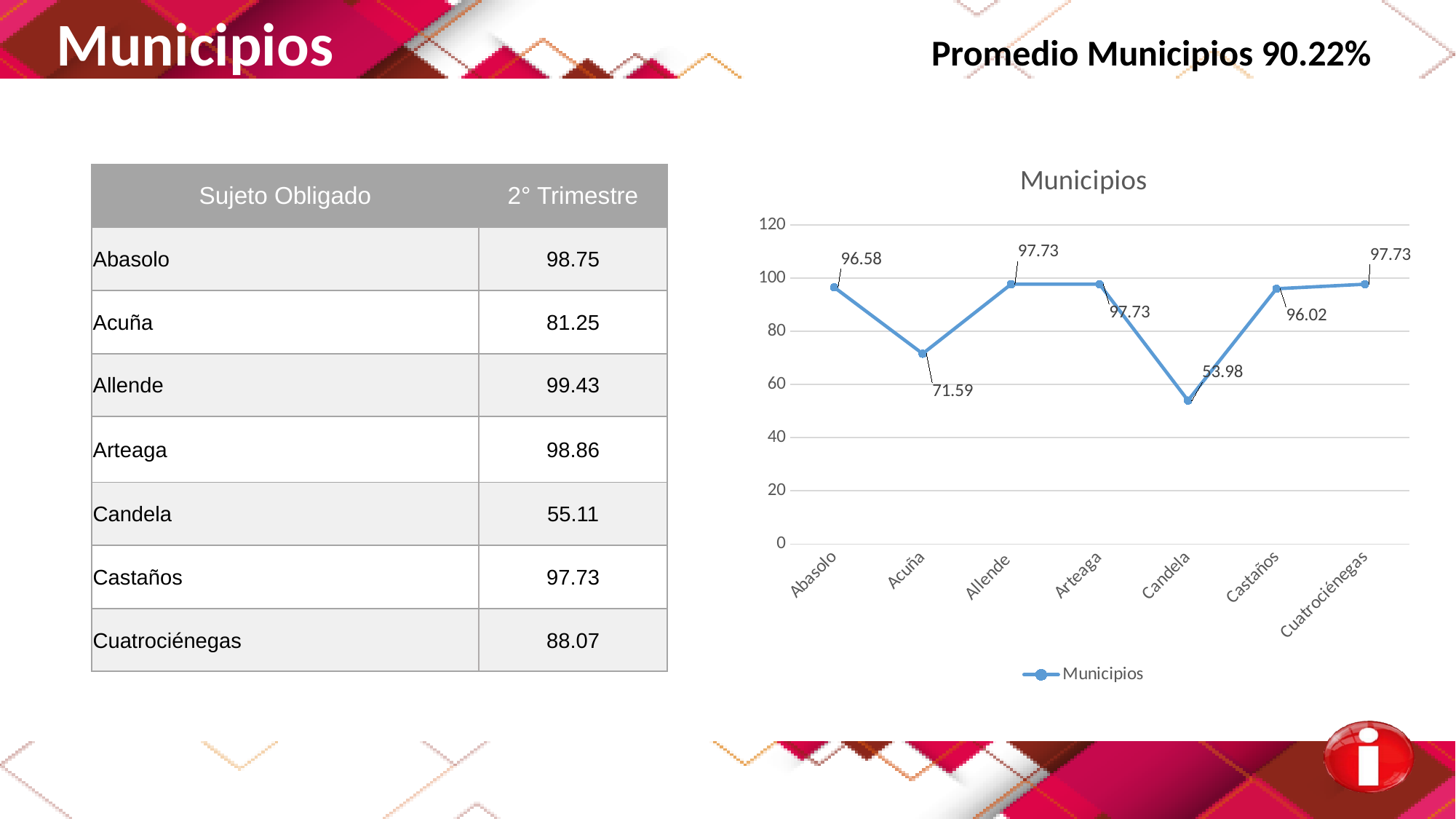
How many categories are plotted in the Municipios chart? 7 What kind of chart is the Municipios chart? line chart What is the value for Candela in the Municipios chart? 53.98 How many series does the legend of the Municipios chart list? 1 Which category has the lowest value in the Municipios chart? Candela Which is larger in the Municipios chart, the value for Castaños or the value for Candela? Castaños What is the title of the chart on the slide? Municipios What is the value for Acuña in the Municipios chart? 71.59 What is the value for Castaños in the Municipios chart? 96.02 What is the difference between the values for Abasolo and Acuña in the Municipios chart? 24.99 Is the value for Candela in the Municipios chart greater or less than 60? less What is the value for Abasolo in the Municipios chart? 96.58